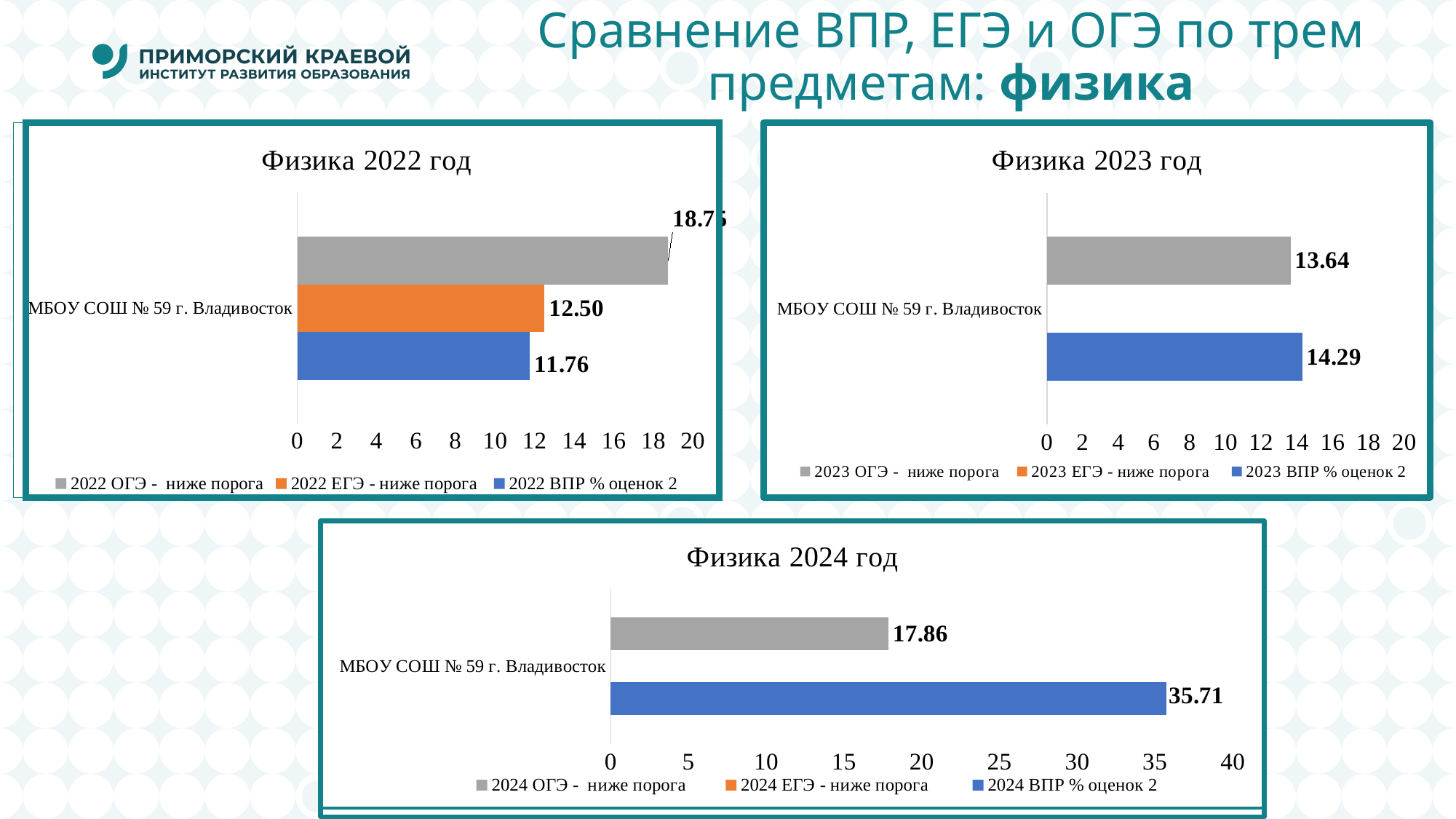
In the chart titled "Физика 2022 год", is the value for "2022 ОГЭ - ниже порога" greater or less than 16? greater What type of chart is the chart titled "Физика 2022 год"? bar chart In the chart titled "Физика 2024 год", what is the value for "2024 ВПР % оценок 2"? 35.71 In the chart titled "Физика 2022 год", what is the value for "2022 ЕГЭ - ниже порога"? 12.50 In the chart titled "Физика 2024 год", what is the difference between the "2024 ВПР % оценок 2" value and the "2024 ОГЭ - ниже порога" value? 17.85 In the chart titled "Физика 2024 год", how many series does the legend list? 3 In the chart titled "Физика 2023 год", what is the value for "2023 ВПР % оценок 2"? 14.29 In the chart titled "Физика 2022 год", what is the difference between the "2022 ЕГЭ - ниже порога" value and the "2022 ВПР % оценок 2" value? 0.74 In the chart titled "Физика 2024 год", what is the value for "2024 ОГЭ - ниже порога"? 17.86 In the chart titled "Физика 2023 год", what is the value for "2023 ОГЭ - ниже порога"? 13.64 In the chart titled "Физика 2022 год", what is the value for "2022 ВПР % оценок 2"? 11.76 In the chart titled "Физика 2023 год", which is larger: "2023 ОГЭ - ниже порога" or "2023 ВПР % оценок 2"? 2023 ВПР % оценок 2